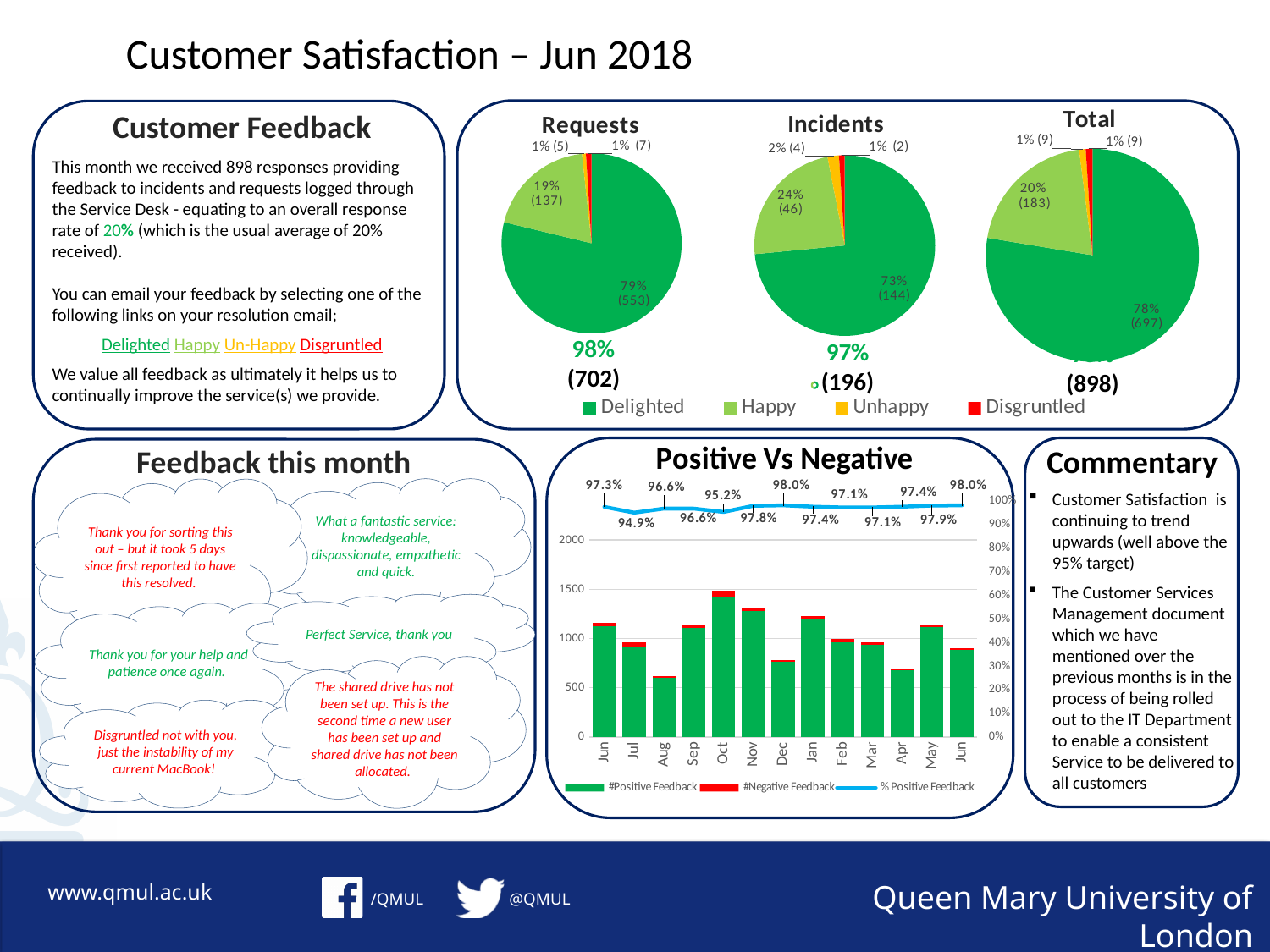
How many months are shown on the x axis of the Positive Vs Negative chart? 13 What kind of chart is the Positive Vs Negative chart? Bar chart with a line In the Total pie chart, what share of responses were Happy? 20% How many categories does the legend under the pie charts list? 4 In the Incidents pie chart, how many responses were Happy? 46 In the Positive Vs Negative chart, which month has the tallest bar? Oct In the Requests pie chart, what percentage of responses were Delighted? 79% In the Positive Vs Negative chart, is the bar for Aug greater or less than 1000? less Which pie chart has the larger Delighted share, Requests or Incidents? Requests How many series does the legend of the Positive Vs Negative chart list? 3 In the Requests pie chart, what is the difference between the number of Delighted and Happy responses? 416 In the Total pie chart, how many responses were Delighted? 697